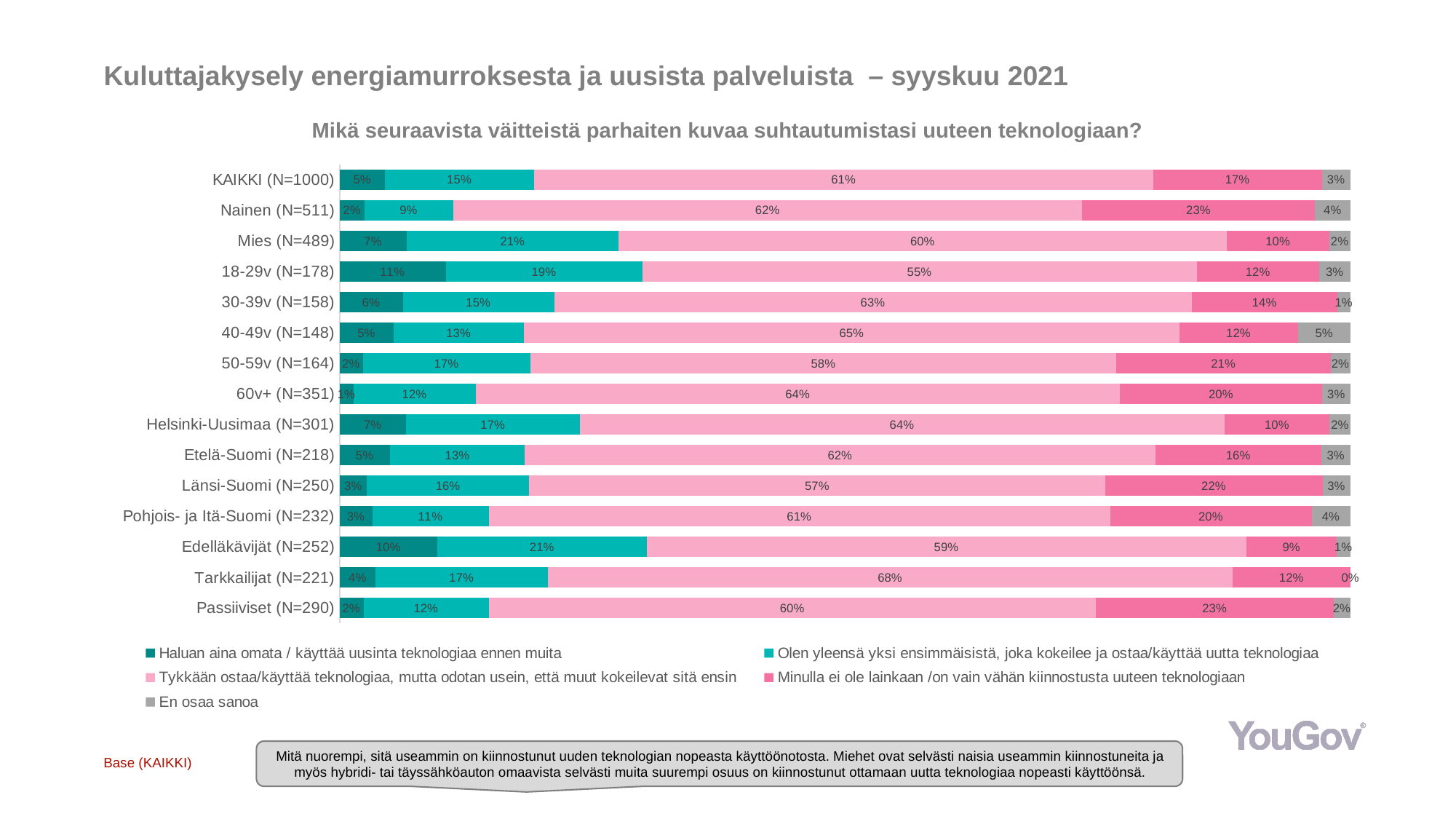
What is the total of the stacked bar for Mies (N=489)? 100% Which has the larger value for "Minulla ei ole lainkaan /on vain vähän kiinnostusta uuteen teknologiaan": Nainen (N=511) or Mies (N=489)? Nainen (N=511) What is the difference between Mies (N=489) and Nainen (N=511) for "Olen yleensä yksi ensimmäisistä, joka kokeilee ja ostaa/käyttää uutta teknologiaa"? 12 percentage points How many categories (rows) are plotted in the chart? 15 What kind of chart is shown on the slide? Stacked bar chart Which category has the lowest value for "Minulla ei ole lainkaan /on vain vähän kiinnostusta uuteen teknologiaan"? Edelläkävijät (N=252) Which category has the highest value for "Haluan aina omata / käyttää uusinta teknologiaa ennen muita"? 18-29v (N=178) What is the value of "Minulla ei ole lainkaan /on vain vähän kiinnostusta uuteen teknologiaan" for Nainen (N=511)? 23% What is the value of "Tykkään ostaa/käyttää teknologiaa, mutta odotan usein, että muut kokeilevat sitä ensin" for KAIKKI (N=1000)? 61% What is the value of "Haluan aina omata / käyttää uusinta teknologiaa ennen muita" for Edelläkävijät (N=252)? 10% Which category has the highest value for "Tykkään ostaa/käyttää teknologiaa, mutta odotan usein, että muut kokeilevat sitä ensin"? Tarkkailijat (N=221) How many series does the legend list? 5